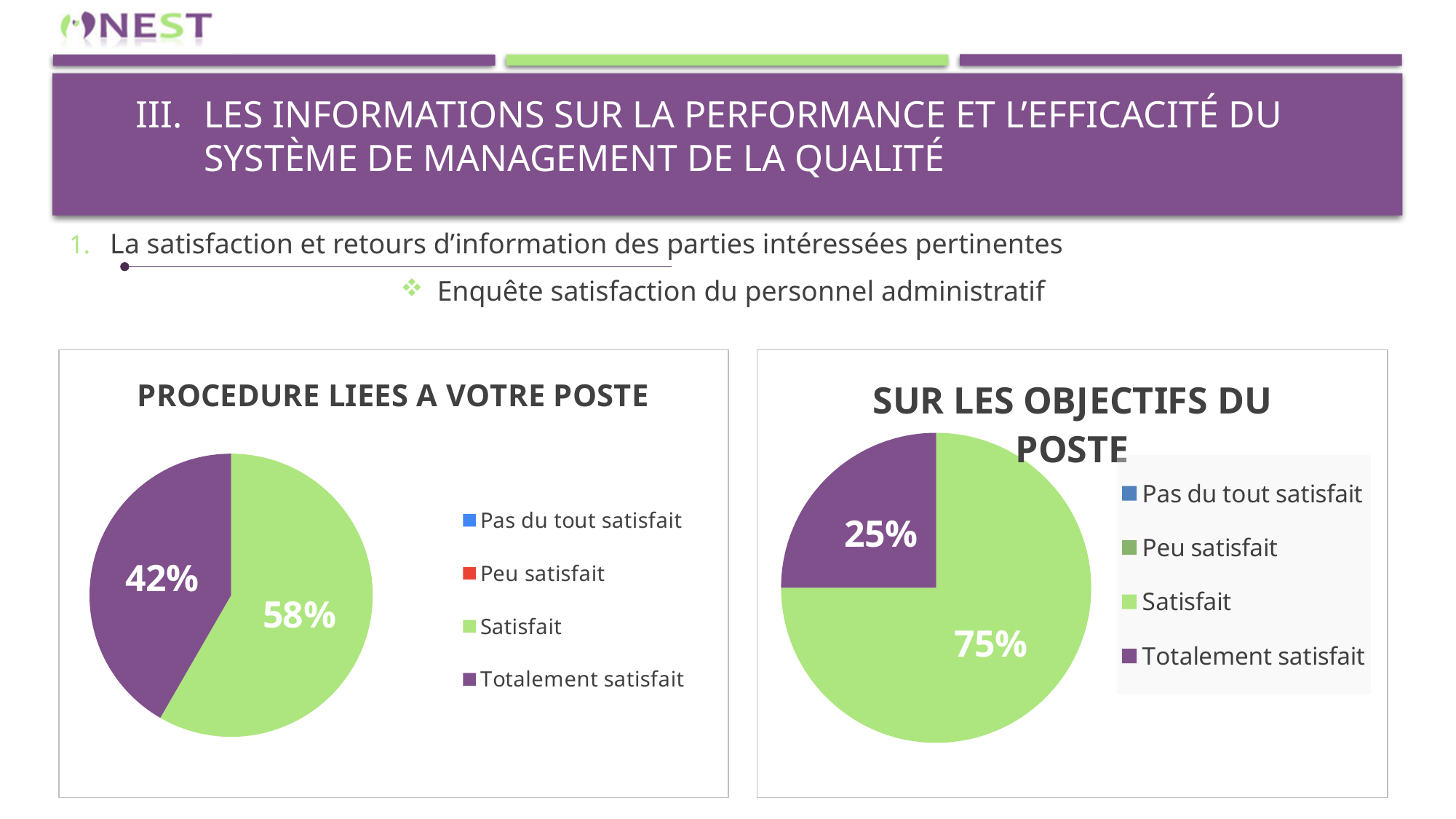
How many entries does the legend of the 'SUR LES OBJECTIFS DU POSTE' chart list? 4 In the 'PROCEDURE LIEES A VOTRE POSTE' chart, which category has the largest slice? Satisfait In the 'SUR LES OBJECTIFS DU POSTE' chart, what is the difference between the 'Satisfait' and 'Totalement satisfait' shares? 50% What type of chart is 'PROCEDURE LIEES A VOTRE POSTE'? Pie chart In the 'PROCEDURE LIEES A VOTRE POSTE' chart, what share of the pie is 'Totalement satisfait'? 42% In the 'SUR LES OBJECTIFS DU POSTE' chart, what share of the pie is 'Totalement satisfait'? 25% In the 'PROCEDURE LIEES A VOTRE POSTE' chart, what colour is the 'Satisfait' slice? Green In the 'SUR LES OBJECTIFS DU POSTE' chart, what share of the pie is 'Satisfait'? 75% In the 'SUR LES OBJECTIFS DU POSTE' chart, which is larger: 'Satisfait' or 'Totalement satisfait'? Satisfait In the 'PROCEDURE LIEES A VOTRE POSTE' chart, what is the difference between the 'Satisfait' and 'Totalement satisfait' shares? 16% In the 'SUR LES OBJECTIFS DU POSTE' chart, which category has the largest slice? Satisfait